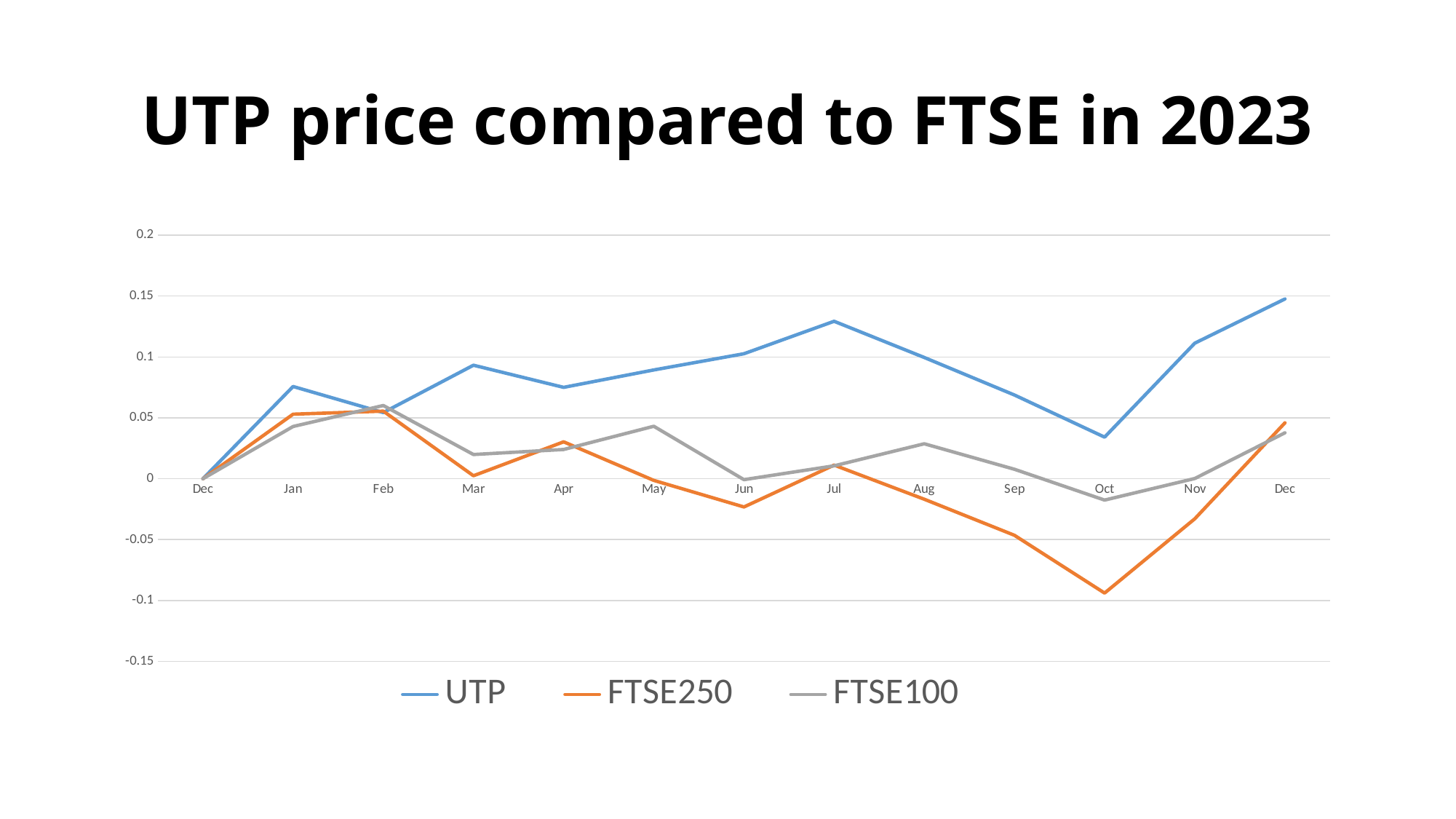
How many months are plotted along the x axis? 13 Which series is drawn in orange? FTSE250 In Sep, which is larger: FTSE100 or FTSE250? FTSE100 In which month does the FTSE250 line reach its lowest value? Oct What kind of chart is shown on the slide? line chart Does the UTP line rise or fall from Jul to Oct? fall Is the value for UTP in Jul greater or less than 0.1? greater In which month does the UTP line reach its highest value? Dec (the final month) Is the value for FTSE250 in Oct greater or less than -0.05? less How many series does the legend list? 3 What is the title of the chart? UTP price compared to FTSE in 2023 Is the value for UTP in Oct greater or less than 0.05? less